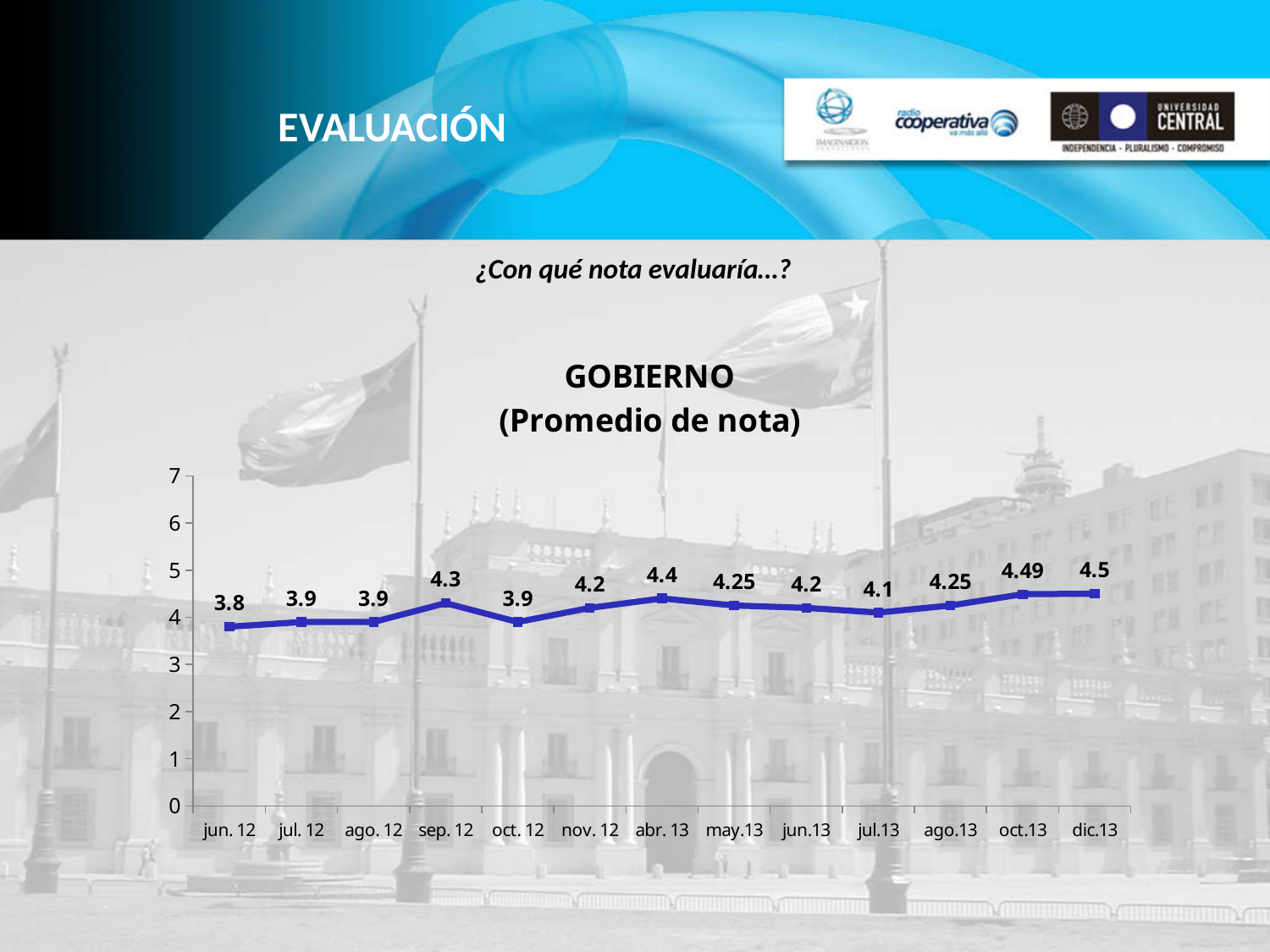
What is the value for jun. 12? 3.8 What is the difference between the values for abr. 13 and oct. 12? 0.5 What is the difference between the values for dic.13 and jun. 12? 0.7 Which is larger, the value for sep. 12 or the value for oct. 12? sep. 12 What kind of chart is shown? line chart What is the value for sep. 12? 4.3 What is the value for oct.13? 4.49 Is the value for jun. 12 greater or less than 4? less How many periods are plotted on the x axis? 13 Which period has the lowest value? jun. 12 What is the value for abr. 13? 4.4 Do the values generally rise or fall from jun. 12 to dic.13? rise